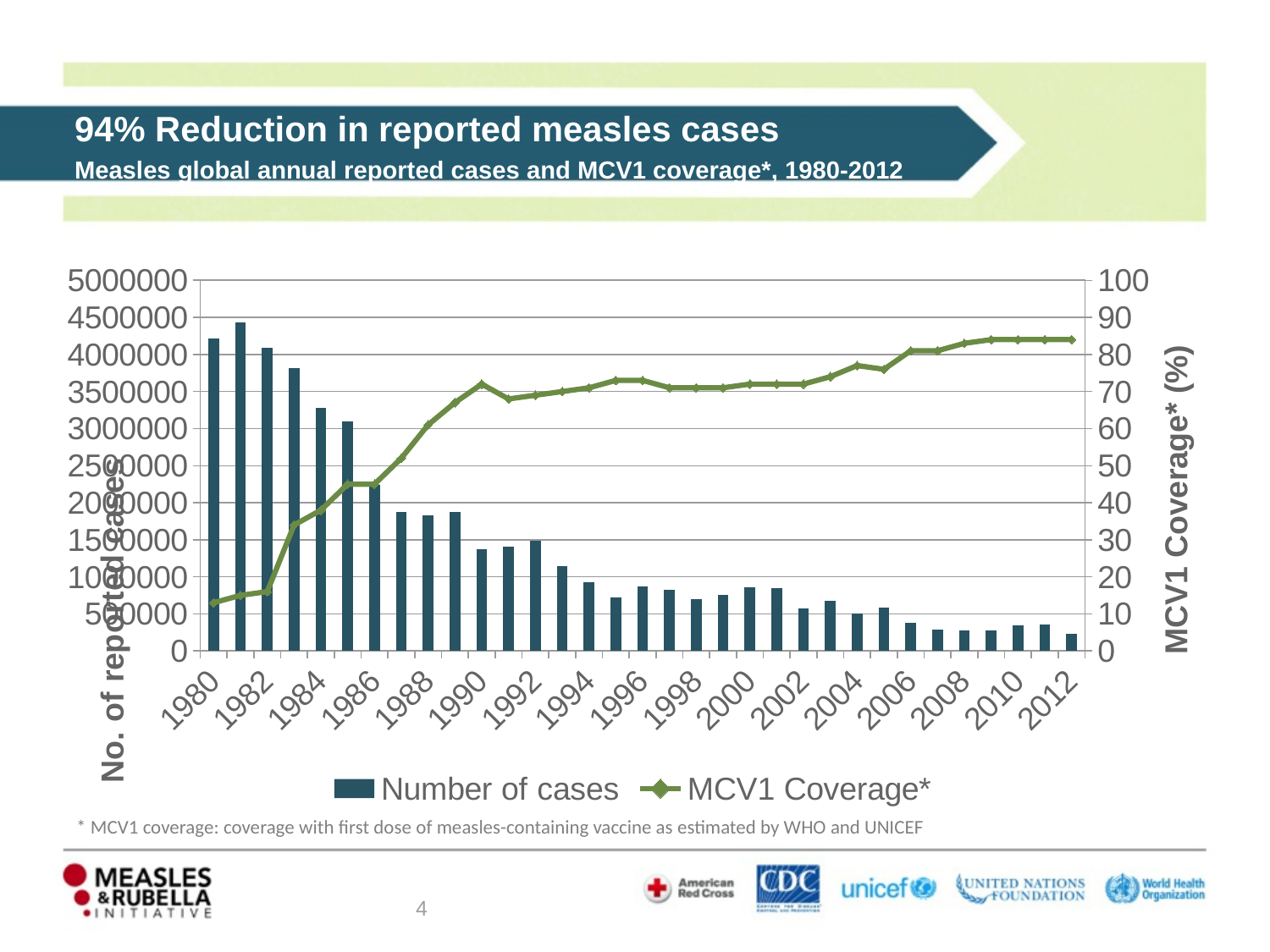
What are the two series named in the legend? Number of cases and MCV1 Coverage* What is the title of the right-hand vertical axis? MCV1 Coverage* (%) Is the MCV1 coverage for 1980 greater or less than 20? less Is the number of cases for 1990 greater or less than 2000000? less Does the MCV1 coverage line generally rise or fall from 1980 to 2012? rise What kind of chart is shown on the slide? A combined bar and line chart Which year has more reported cases, 2000 or 2005? 2000 Is the number of cases for 1980 greater or less than 4000000? greater Which year has the highest number of reported cases? 1981 How many years (bars) are plotted on the chart? 33 How many series does the legend list? 2